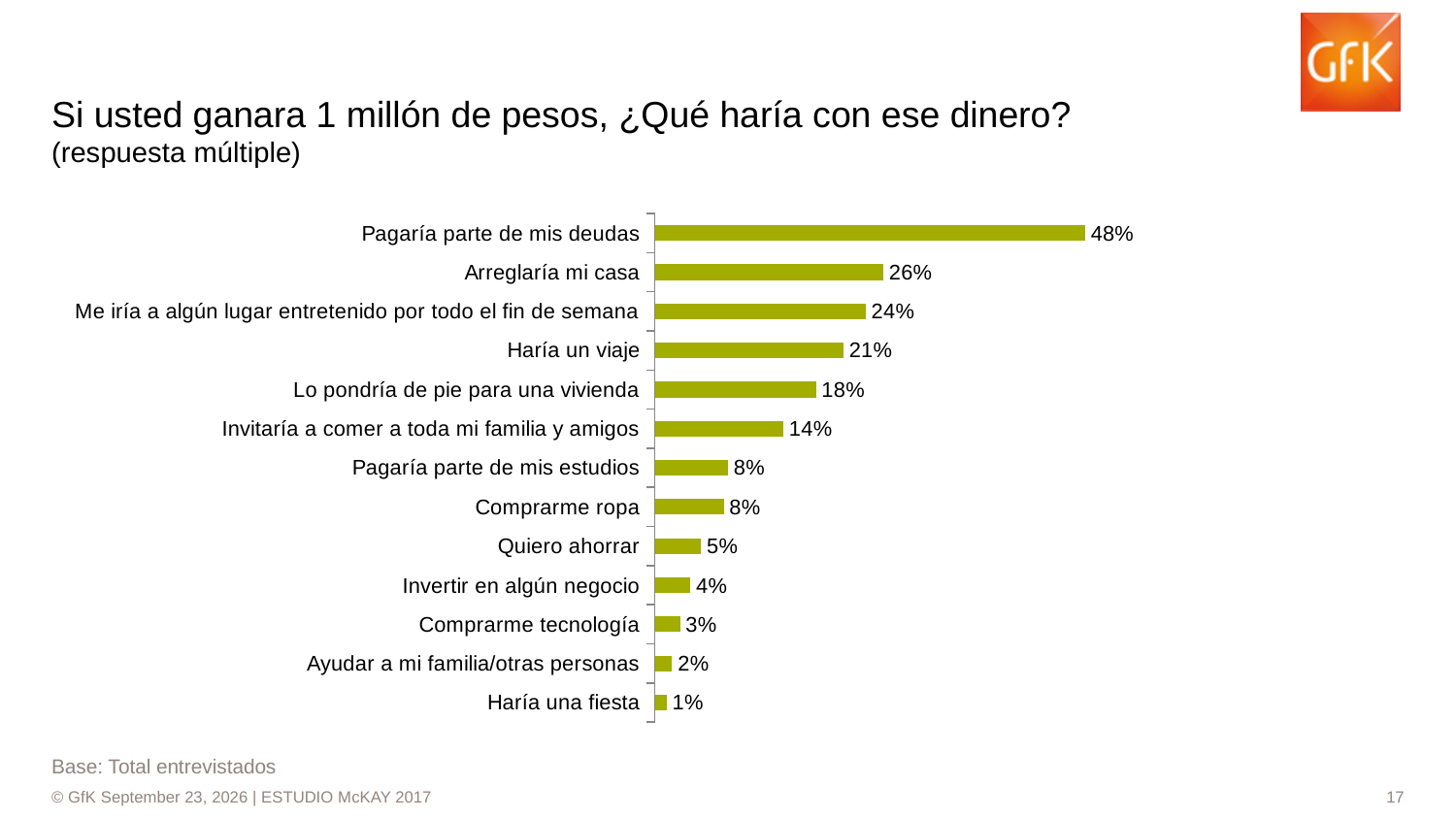
What kind of chart is shown on the slide? Bar chart Which is larger: "Invitaría a comer a toda mi familia y amigos" or "Comprarme ropa"? Invitaría a comer a toda mi familia y amigos Which category has the highest value? Pagaría parte de mis deudas Which category has the lowest value? Haría una fiesta How many categories are shown in the chart? 13 What is the value for "Comprarme tecnología"? 3% What is the difference between "Pagaría parte de mis deudas" and "Lo pondría de pie para una vivienda"? 30% What is the difference between "Arreglaría mi casa" and "Haría un viaje"? 5% What is the value for "Quiero ahorrar"? 5% What base is stated below the chart? Total entrevistados What percentage of respondents said "Pagaría parte de mis deudas"? 48% What is the value for "Haría un viaje"? 21%